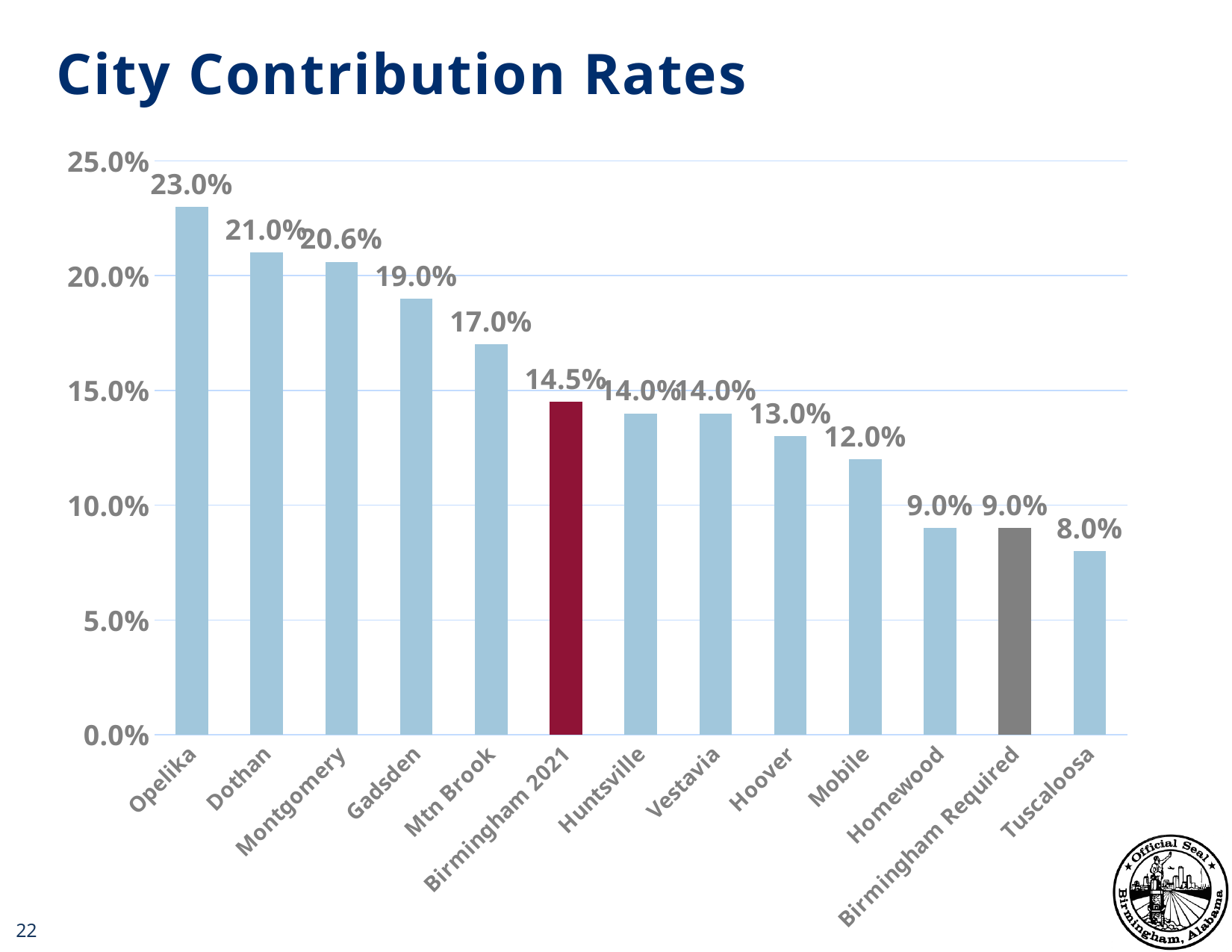
Is the value for Hoover greater or less than 15.0%? less How many categories are shown on the x axis? 13 What is the city contribution rate for Birmingham 2021? 14.5% What is the city contribution rate for Opelika? 23.0% Which city has the lowest contribution rate? Tuscaloosa Which has a higher contribution rate, Gadsden or Mtn Brook? Gadsden What is the city contribution rate for Montgomery? 20.6% What is the difference between the contribution rates of Opelika and Tuscaloosa? 15.0% What kind of chart is shown on the slide? Bar chart Which city has the highest contribution rate? Opelika What is the title of the chart? City Contribution Rates What is the difference between the Birmingham 2021 rate and the Birmingham Required rate? 5.5%